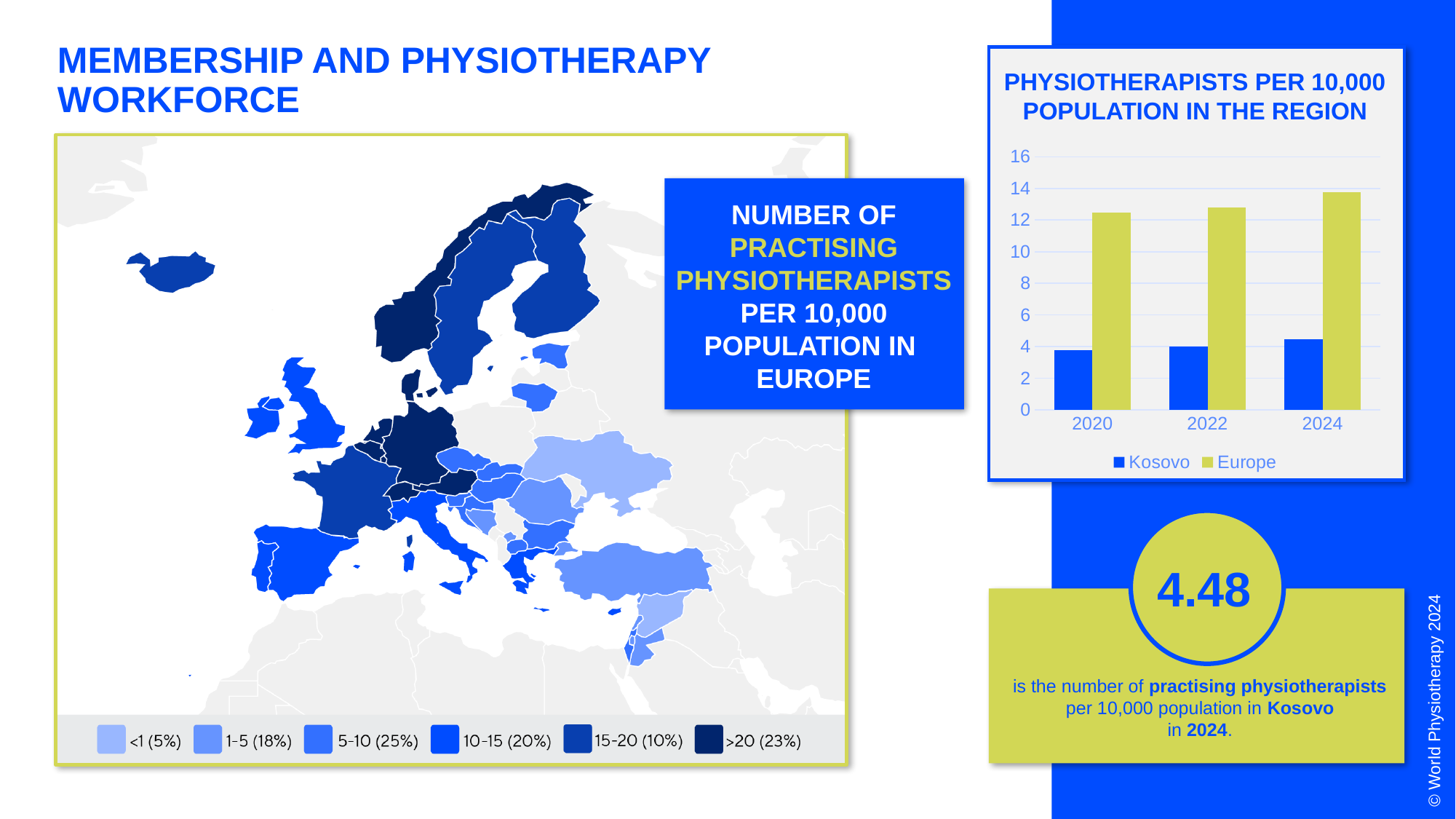
In the 'Physiotherapists per 10,000 population in the region' chart, is the value for Europe in 2020 greater or less than 10? greater What are the two legend entries in the 'Physiotherapists per 10,000 population in the region' chart? Kosovo and Europe What kind of chart is 'Physiotherapists per 10,000 population in the region'? Bar chart In the 'Physiotherapists per 10,000 population in the region' chart, do the Europe values rise or fall from 2020 to 2024? Rise In the 'Physiotherapists per 10,000 population in the region' chart, in which year is the Kosovo value lowest? 2020 In the map legend for practising physiotherapists per 10,000 population in Europe, which range has the largest share of countries? 5-10 (25%) In the 'Physiotherapists per 10,000 population in the region' chart, in which year is the Europe value highest? 2024 How many years are shown on the x axis of the 'Physiotherapists per 10,000 population in the region' chart? 3 How many series does the legend of the 'Physiotherapists per 10,000 population in the region' chart list? 2 In the 'Physiotherapists per 10,000 population in the region' chart, which is larger in 2020, Kosovo or Europe? Europe In the 'Physiotherapists per 10,000 population in the region' chart, is the value for Kosovo in 2022 greater or less than 6? less In the 'Physiotherapists per 10,000 population in the region' chart, what is the value for Kosovo in 2024? 4.48